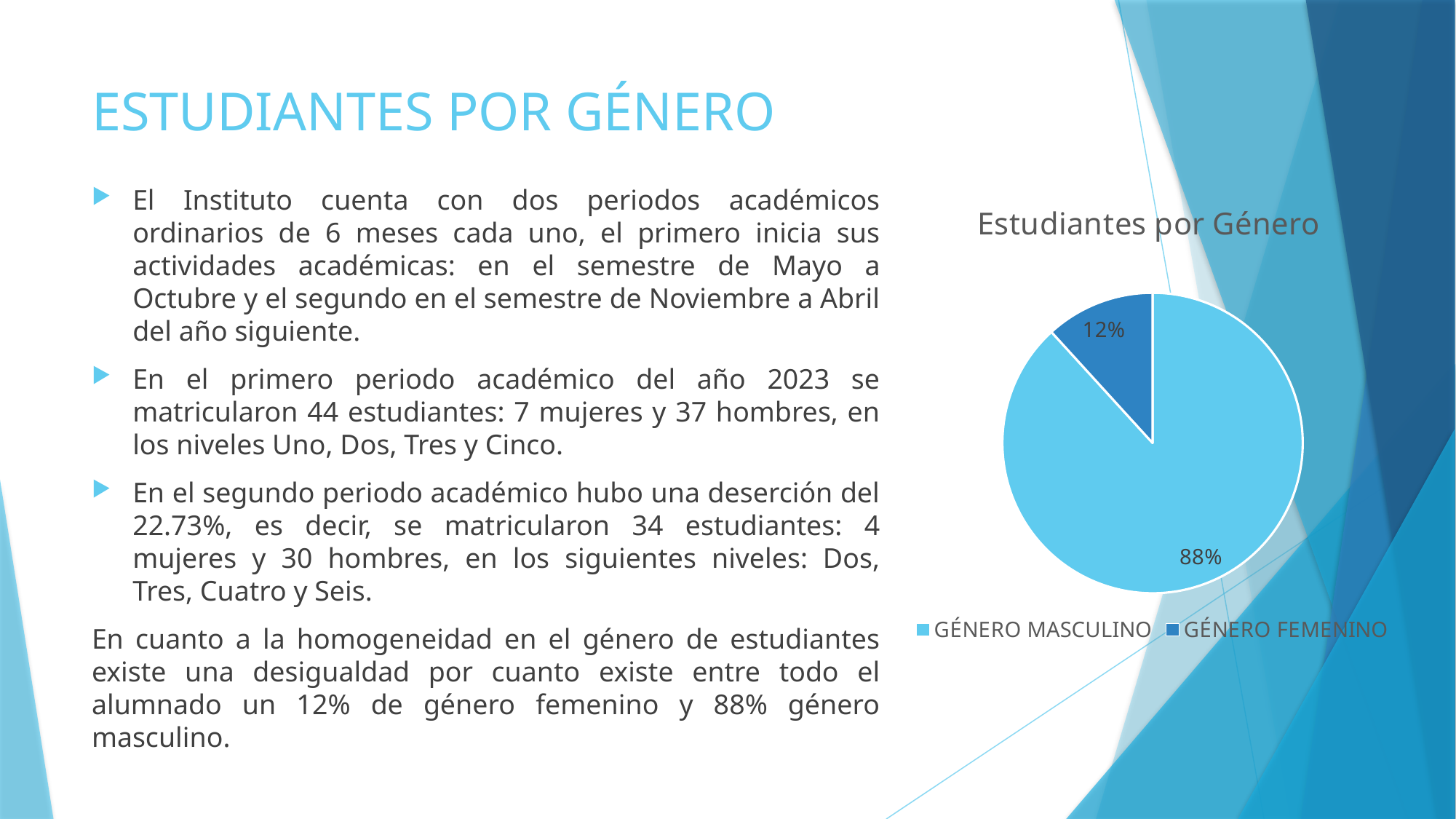
How many entries does the legend list? 2 Which legend entry is shown in the darker blue colour? GÉNERO FEMENINO What is the title of the chart? Estudiantes por Género What is the difference in percentage points between the GÉNERO MASCULINO and GÉNERO FEMENINO slices? 76 What share of the pie does GÉNERO FEMENINO represent? 12% What share of the pie does GÉNERO MASCULINO represent? 88% Which category has the smallest slice of the pie? GÉNERO FEMENINO Which slice is larger, GÉNERO MASCULINO or GÉNERO FEMENINO? GÉNERO MASCULINO How many categories does the pie chart show? 2 Which category has the largest slice of the pie? GÉNERO MASCULINO What kind of chart is shown on the slide? pie chart